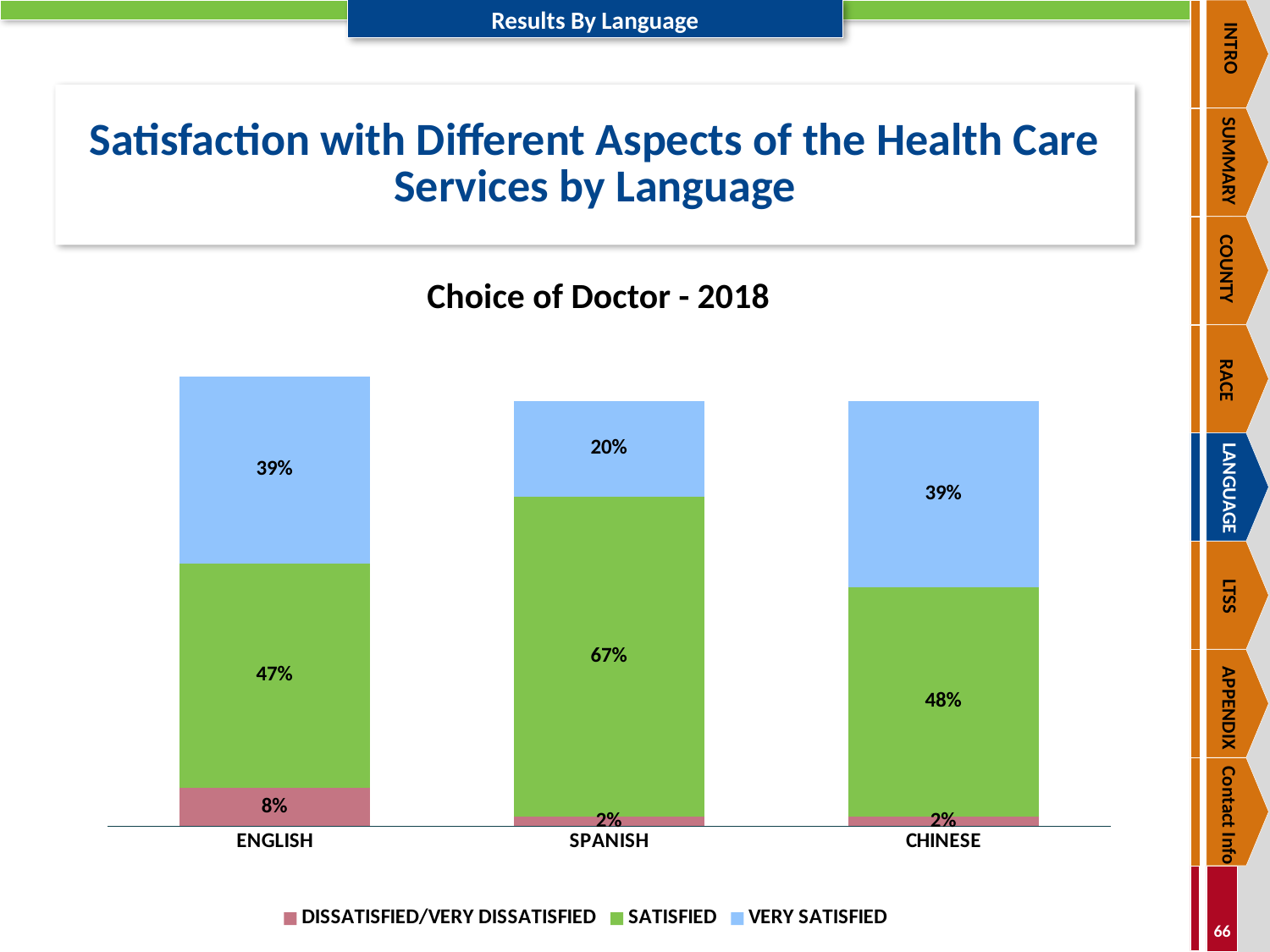
How many series does the legend list? 3 Which language has the lowest Very Satisfied value? Spanish What kind of chart is shown? Stacked bar chart What is the difference between the Satisfied values for Spanish and English? 20% What is the Very Satisfied value for English? 39% What is the Dissatisfied/Very Dissatisfied value for Chinese? 2% Which language has the highest Satisfied value? Spanish How many language categories are shown on the x axis? 3 Which is larger, the Dissatisfied/Very Dissatisfied value for English or for Spanish? English What is the title of the chart? Choice of Doctor - 2018 What is the total of the three labelled segments in the English bar? 94% What is the Satisfied value for Spanish? 67%